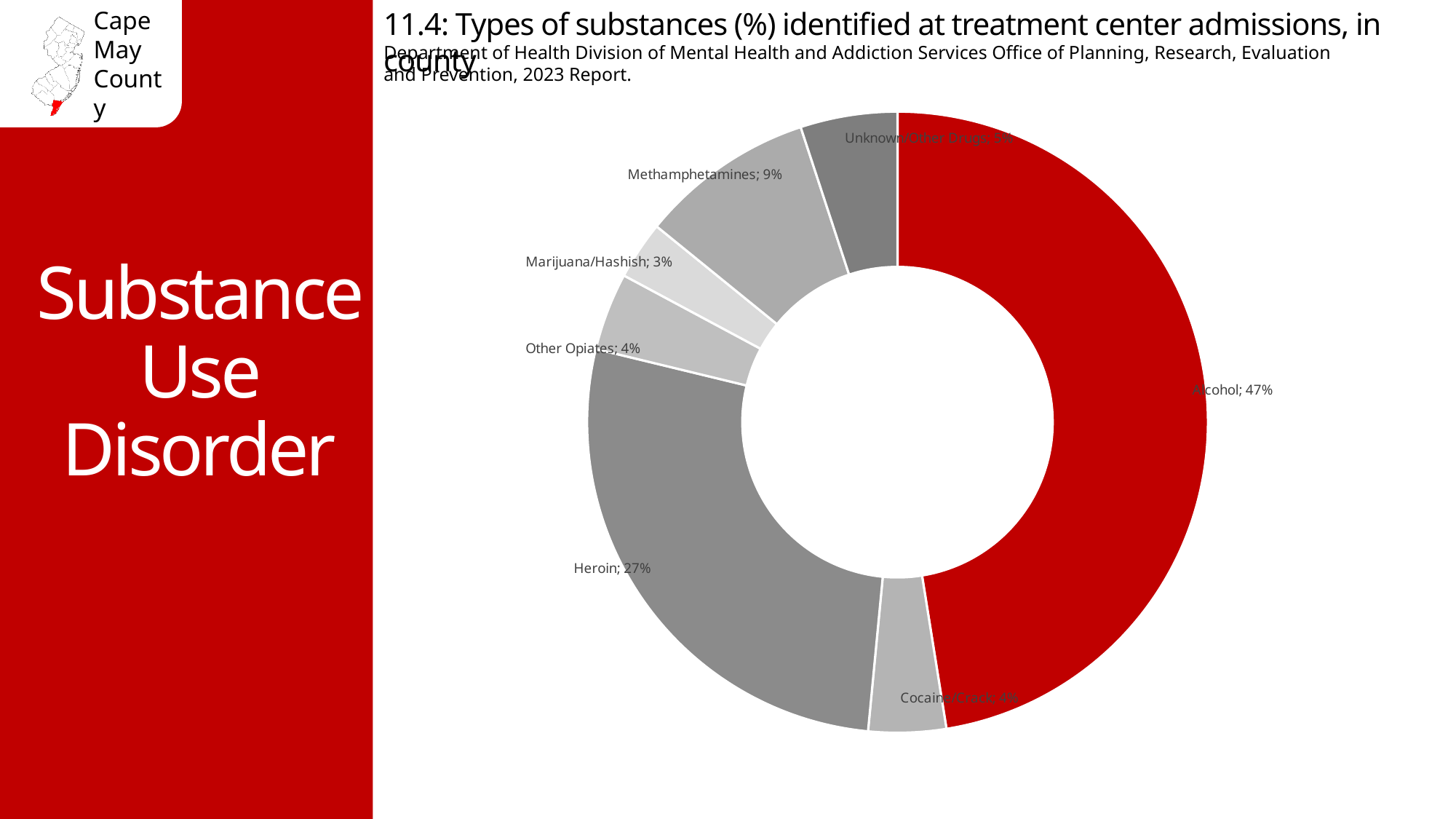
What percentage is shown for Methamphetamines? 9% What is the difference in percentage points between Methamphetamines and Unknown/Other Drugs? 4 What percentage is shown for Marijuana/Hashish? 3% Which has a larger share, Heroin or Methamphetamines? Heroin How many substance categories are shown in the chart? 7 Which substance has the largest share of treatment center admissions? Alcohol What percentage is shown for Unknown/Other Drugs? 5% What is the difference in percentage points between Alcohol and Heroin? 20 What percentage of treatment center admissions identified Heroin? 27% What kind of chart is shown on the slide? Doughnut (pie) chart Which substance has the smallest share of treatment center admissions? Marijuana/Hashish What percentage of treatment center admissions identified Alcohol? 47%